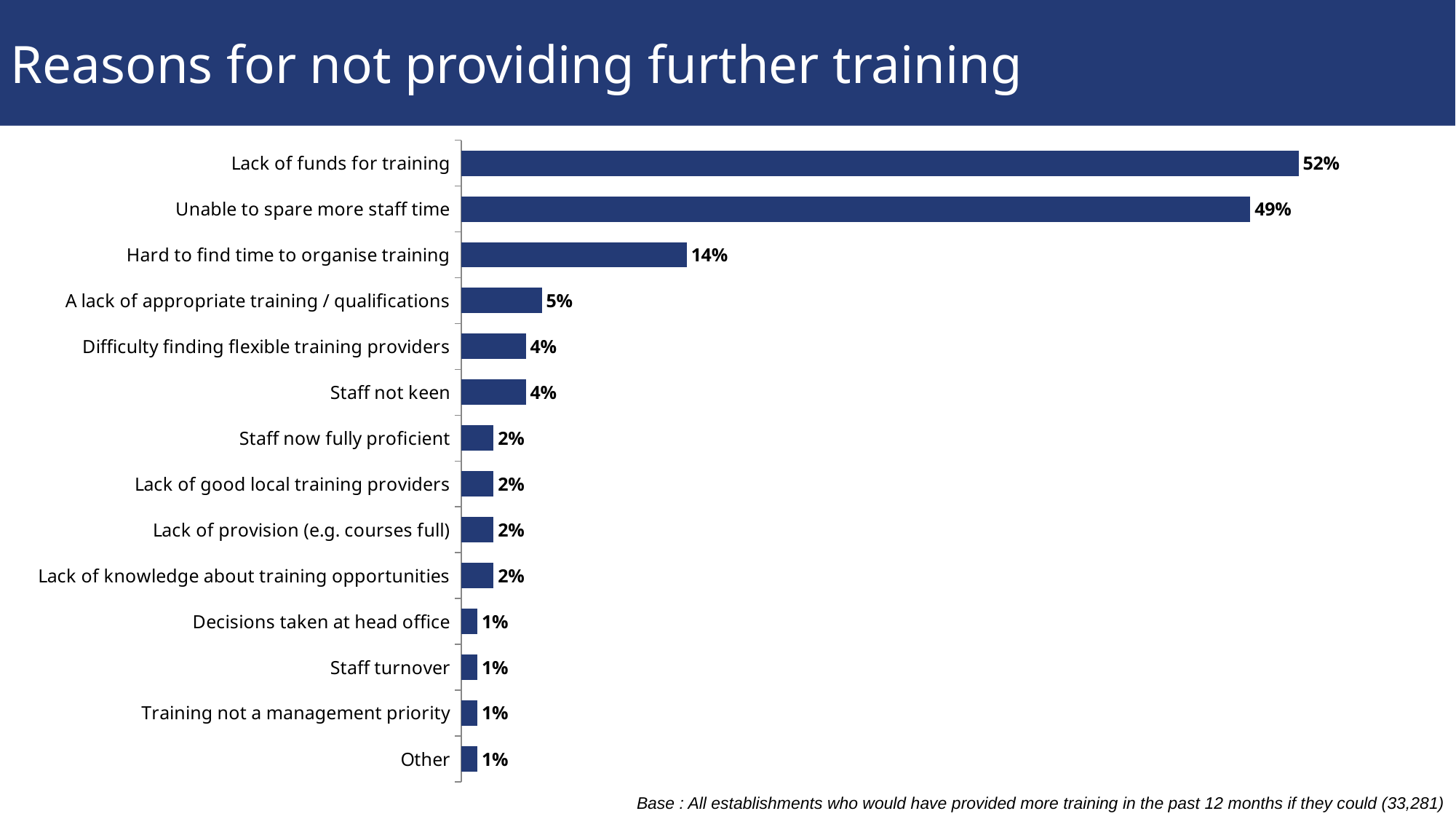
Which reason has the highest percentage? Lack of funds for training What is the title of the slide? Reasons for not providing further training How many reasons (categories) are shown in the chart? 14 Which is larger: the value for 'A lack of appropriate training / qualifications' or the value for 'Staff now fully proficient'? A lack of appropriate training / qualifications What kind of chart is shown on the slide? Bar chart What is the value for 'Decisions taken at head office'? 1% What is the difference between 'Unable to spare more staff time' and 'Hard to find time to organise training'? 35 percentage points What is the difference in percentage points between 'Lack of funds for training' and 'Unable to spare more staff time'? 3 percentage points How many reasons have a value of 1%? 4 What is the value for 'Hard to find time to organise training'? 14% What percentage is shown for 'Staff not keen'? 4% What percentage of establishments cited lack of funds for training as a reason for not providing further training? 52%